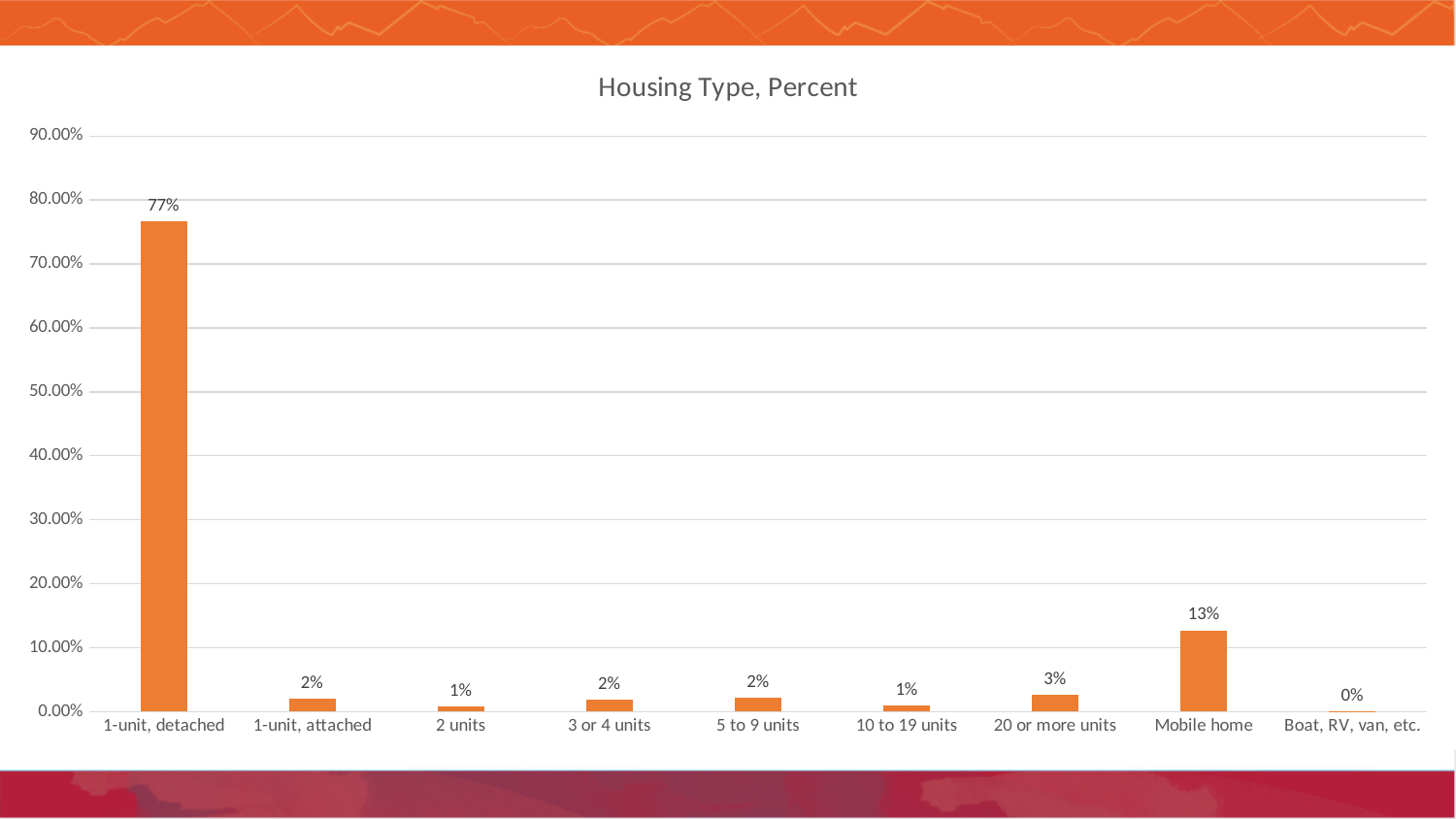
What is the title of the chart? Housing Type, Percent What is the value for 1-unit, detached? 77% Which is larger, the value for Mobile home or the value for 20 or more units? Mobile home Is the value for 1-unit, detached greater or less than 70.00%? greater What is the value for Boat, RV, van, etc.? 0% What is the difference between the values for 1-unit, detached and Mobile home? 64% What is the value for 20 or more units? 3% What is the value for Mobile home? 13% Which housing type has the lowest percentage? Boat, RV, van, etc. How many housing type categories are shown on the chart? 9 Which housing type has the highest percentage? 1-unit, detached What kind of chart is shown on the slide? Bar chart